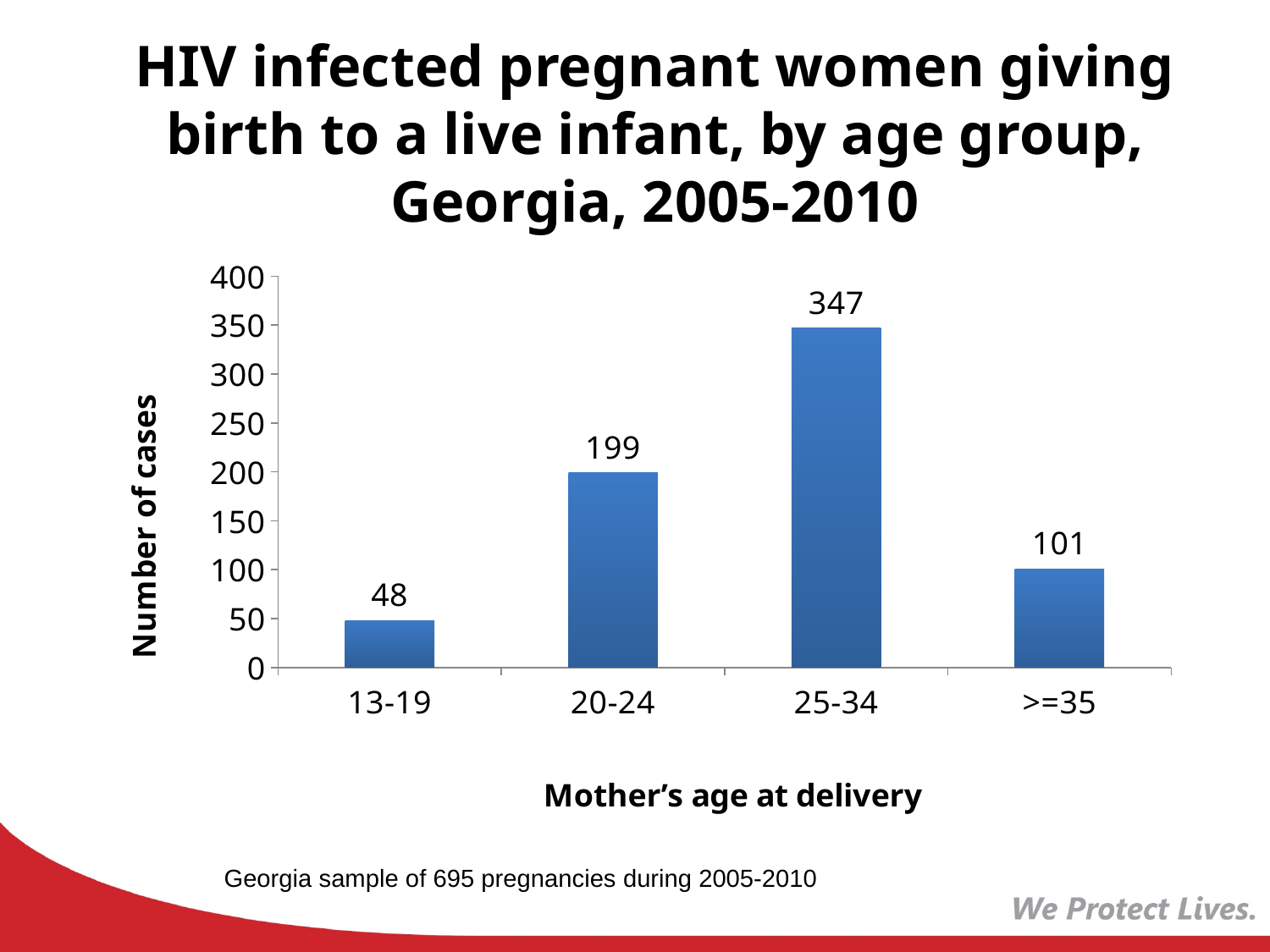
Which age group has the lowest number of cases? 13-19 What is the number of cases for the >=35 age group? 101 What is the label of the y axis? Number of cases Which age group has more cases, 20-24 or >=35? 20-24 What kind of chart is shown on the slide? bar chart What is the difference in number of cases between the 25-34 and 20-24 age groups? 148 What is the number of cases for the 25-34 age group? 347 Which age group has the highest number of cases? 25-34 What is the number of cases for the 13-19 age group? 48 Is the value for the 20-24 age group greater or less than 150? greater How many age groups are shown on the x axis? 4 What is the difference in number of cases between the >=35 and 13-19 age groups? 53